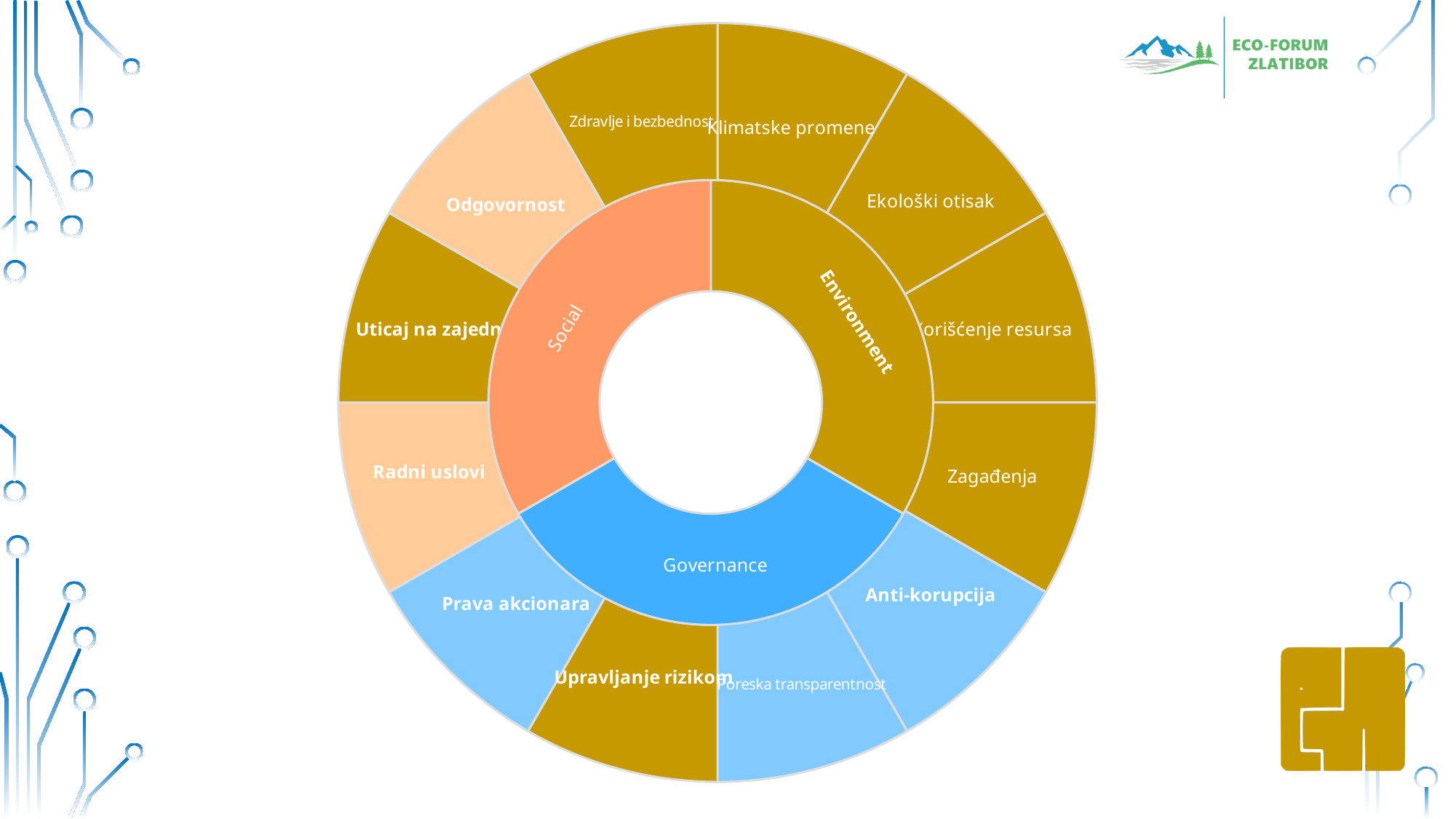
How many outer-ring segments belong to the Environment category? 4 Which inner-ring category does the outer segment "Radni uslovi" belong to? Social Which inner-ring category does the outer segment "Anti-korupcija" belong to? Governance Which inner-ring category does the outer segment "Zagađenja" belong to? Environment What kind of chart is shown on the slide? Sunburst chart What are the three inner-ring categories of the chart? Social, Environment, Governance How many segments are in the outer ring of the chart? 12 How many outer-ring segments belong to the Governance category? 4 What colour is the Governance segment in the inner ring? Blue